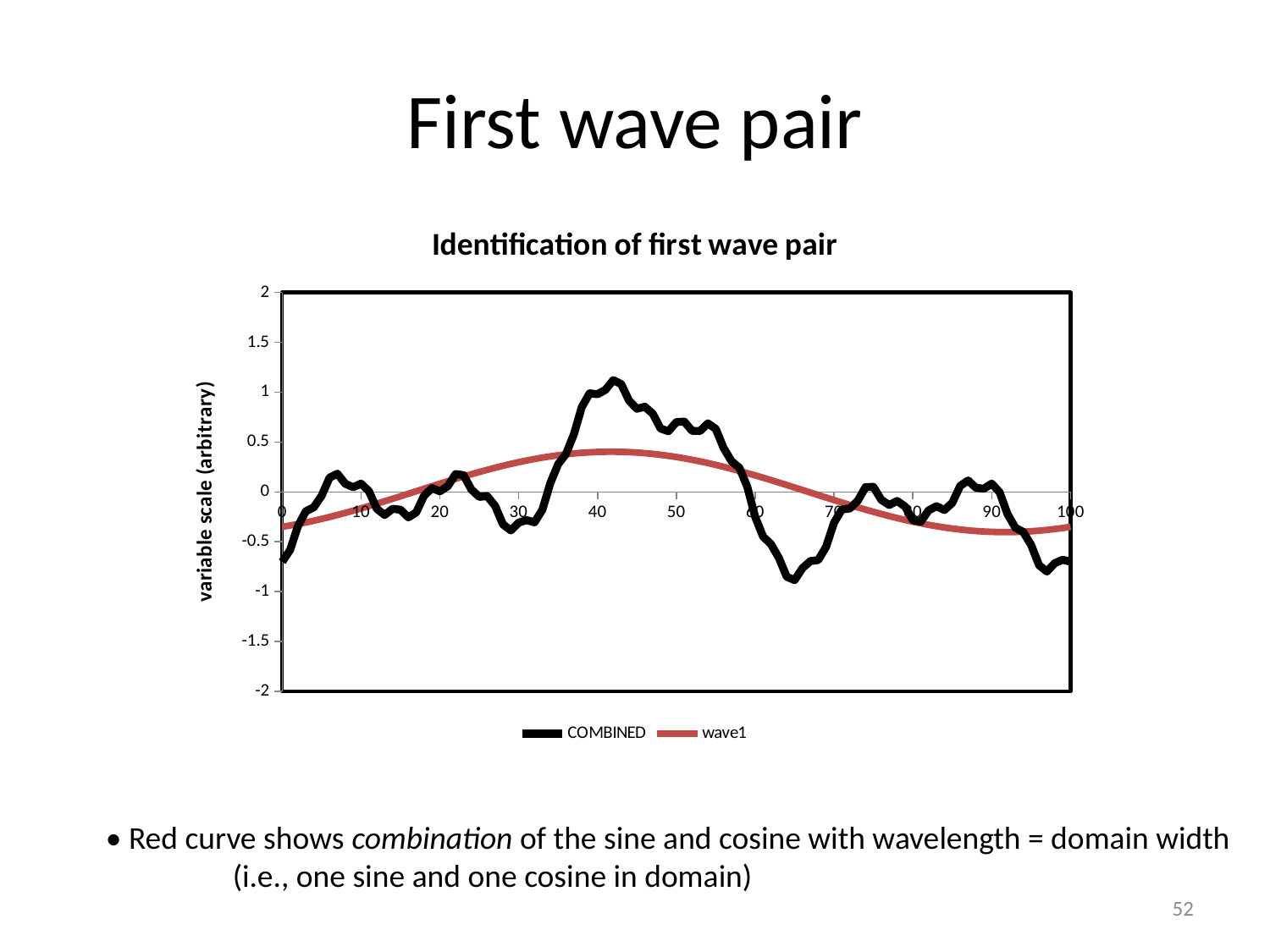
Does the wave1 series rise or fall between x = 0 and x = 40? rise At x = 40, which series has the higher value, COMBINED or wave1? COMBINED What is the label on the vertical axis of the chart? variable scale (arbitrary) At x = 65, which series has the higher value, COMBINED or wave1? wave1 Is the value of the wave1 series at x = 90 greater or less than 0? less Does the wave1 series rise or fall between x = 40 and x = 90? fall Is the value of the COMBINED series at x = 65 greater or less than -0.5? less Is the value of the wave1 series at x = 40 greater or less than 0? greater What kind of chart is shown on the slide? line chart What is the title of the chart? Identification of first wave pair How many series does the legend list? 2